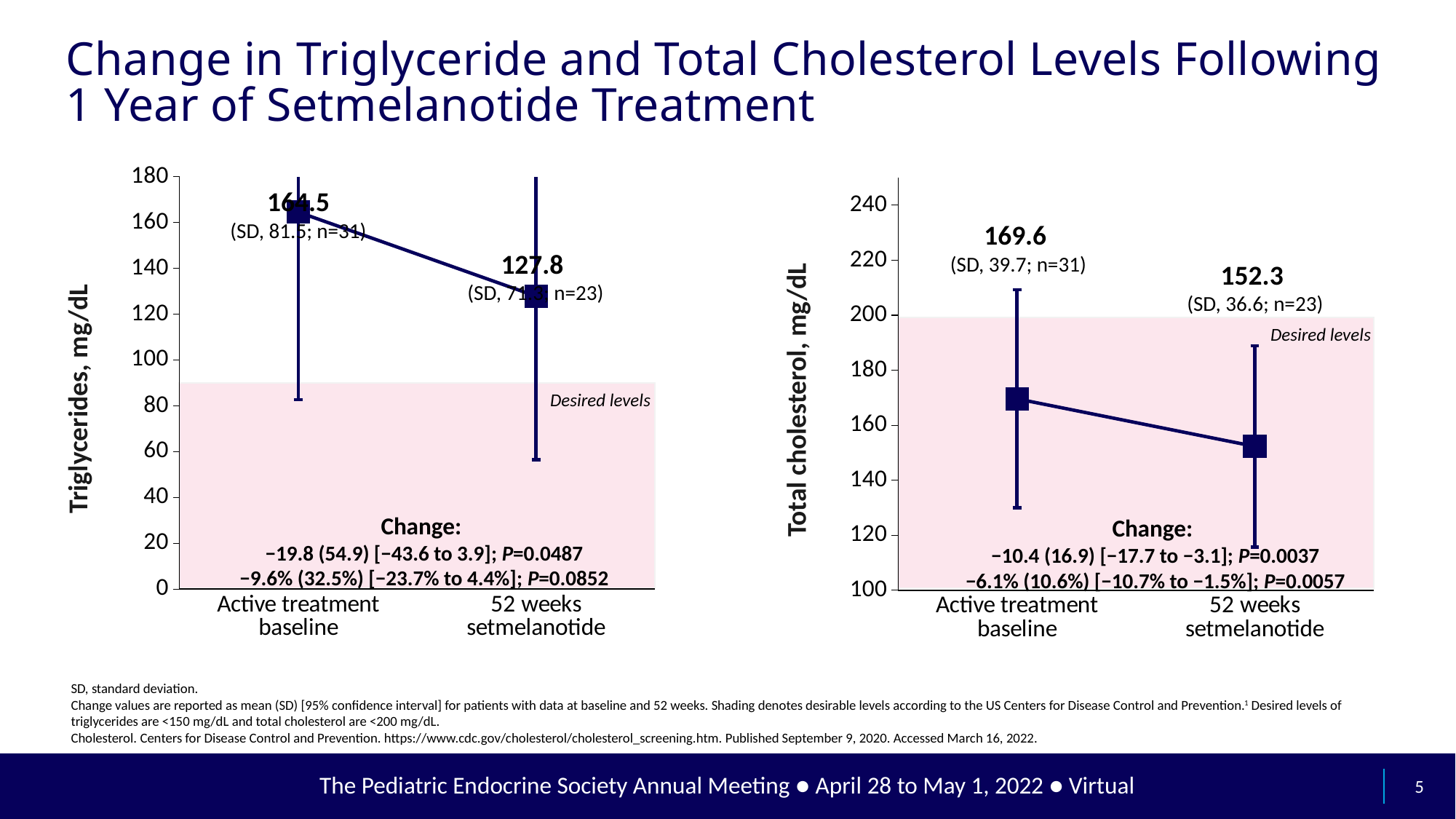
In the Triglycerides chart, what is the difference between the baseline mean and the 52-week mean? 36.7 In the Triglycerides chart, what is the mean triglyceride value at 52 weeks setmelanotide? 127.8 In the Total cholesterol chart, what is the standard deviation reported for the baseline value? 39.7 How many time points are plotted on the x axis of the Triglycerides chart? 2 In the Total cholesterol chart, which time point has the higher mean value, active treatment baseline or 52 weeks setmelanotide? Active treatment baseline In the Triglycerides chart, do the mean values rise or fall from baseline to 52 weeks? fall In the Total cholesterol chart, what is the P value reported for the absolute change of −10.4? P=0.0037 In the Total cholesterol chart, what is the difference between the baseline mean and the 52-week mean? 17.3 In the Total cholesterol chart, what is the mean total cholesterol value at 52 weeks setmelanotide? 152.3 In the Triglycerides chart, what is the mean triglyceride value at active treatment baseline? 164.5 In the Total cholesterol chart, how many patients (n) are reported at 52 weeks setmelanotide? 23 In the Total cholesterol chart, what is the mean total cholesterol value at active treatment baseline? 169.6